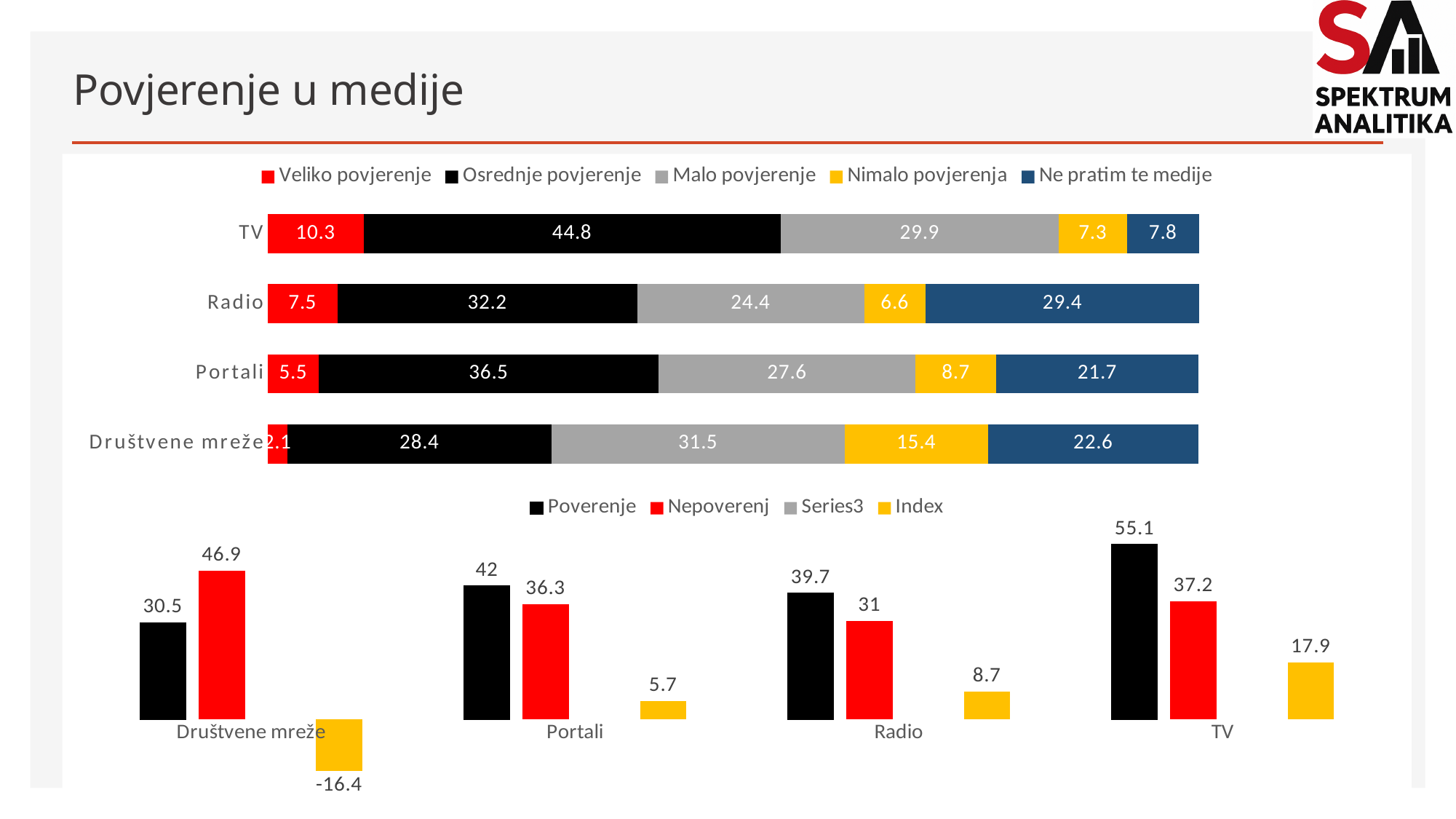
In the top stacked bar chart, what is the difference between the 'Malo povjerenje' values for Društvene mreže and Radio? 7.1 In the bottom bar chart, is the 'Poverenje' value or the 'Nepoverenj' value larger for Portali? Poverenje In the top stacked bar chart, what is the value of 'Osrednje povjerenje' for TV? 44.8 In the bottom bar chart, which category has the highest 'Poverenje' value? TV In the bottom bar chart, what is the 'Index' value for Društvene mreže? -16.4 How many categories are shown on the x axis of the bottom bar chart? 4 In the top stacked bar chart, which category has the highest 'Nimalo povjerenja' value? Društvene mreže In the top stacked bar chart, what is the value of 'Ne pratim te medije' for Radio? 29.4 How many series does the legend of the top stacked bar chart list? 5 What type of chart is the top chart on the slide? Stacked bar chart In the bottom bar chart, what is the difference between the 'Poverenje' and 'Nepoverenj' values for TV? 17.9 In the top stacked bar chart, which category has the lowest 'Veliko povjerenje' value? Društvene mreže